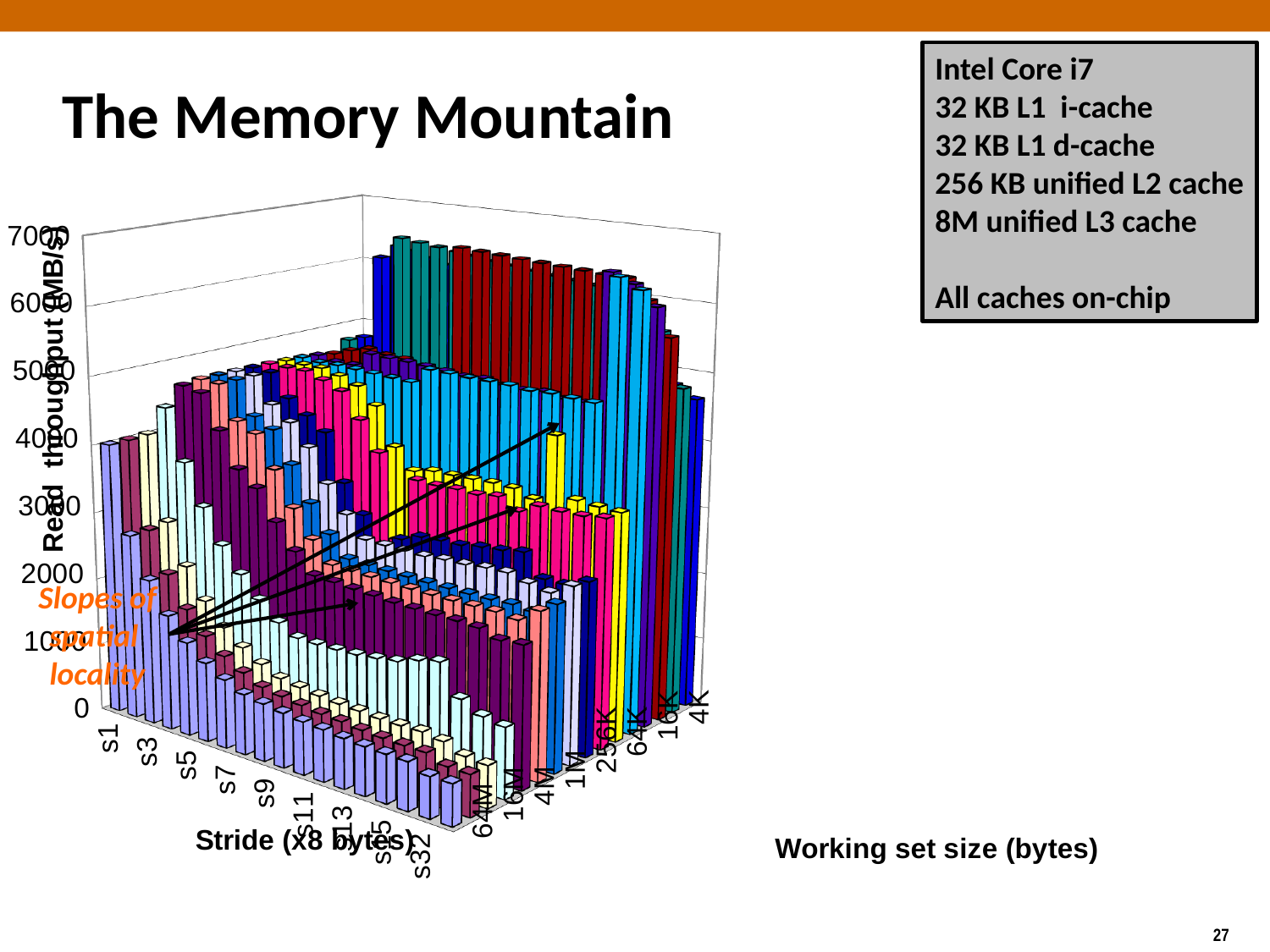
For the 64M working set, does read throughput rise or fall as the stride increases from s1 to s32? fall For the 64M working set, which stride gives the highest read throughput? s1 What is the highest value shown on the vertical axis of the chart? 7000 What is the largest working set size labeled on the chart? 64M What is the smallest working set size labeled on the chart? 4K Which is larger: the read throughput at stride s1 or at stride s32 for the 64M working set? s1 Is the read throughput for stride s32 at the 64M working set greater or less than 2000? less What is the title of the chart on the slide? The Memory Mountain What quantity is plotted on the vertical axis of the chart? Read throughput (MB/s) How many working set size labels are shown along the working set size axis? 8 What kind of chart is shown on the slide? 3D bar chart